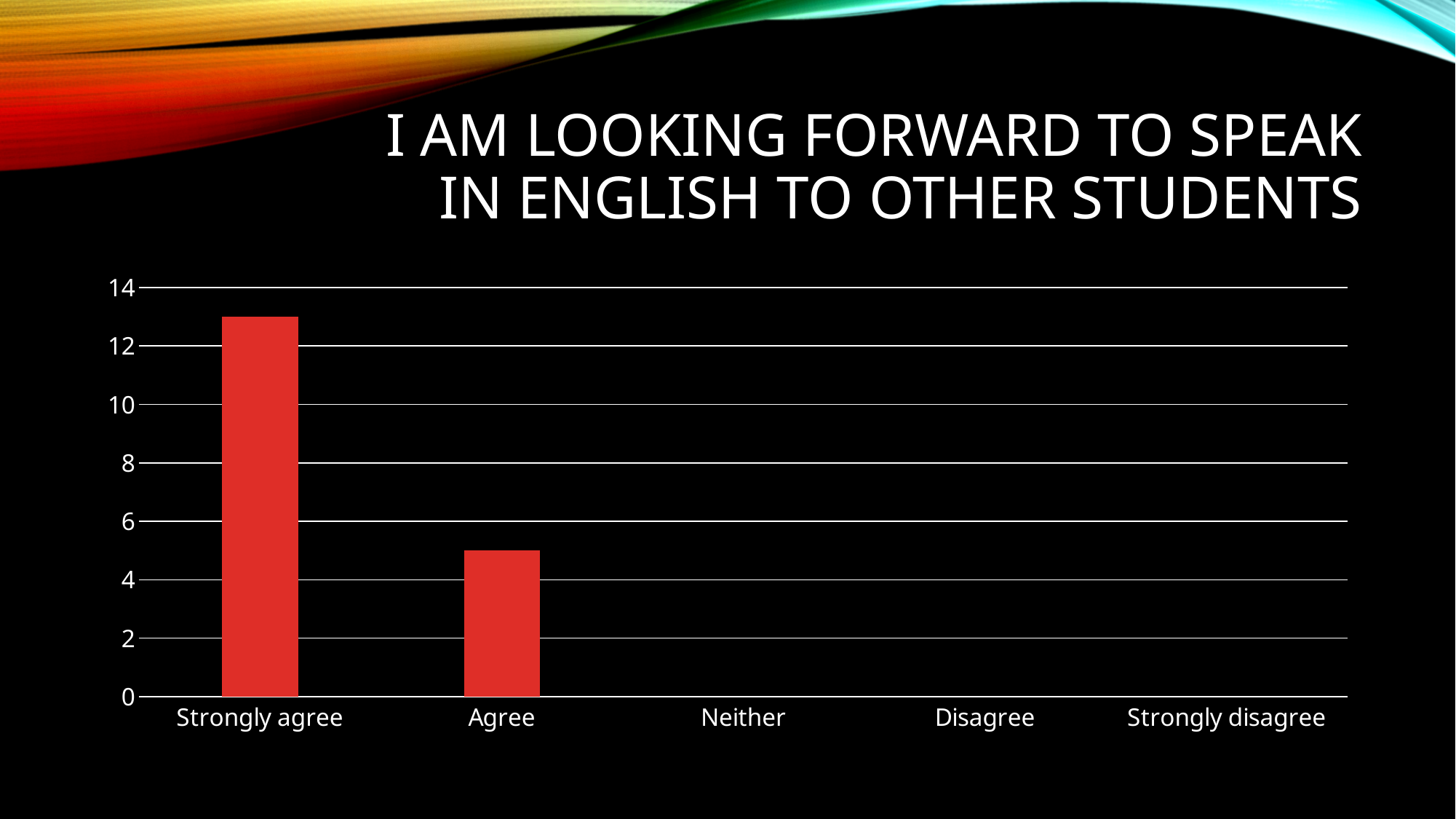
What kind of chart is shown on the slide? bar chart Is the value for Strongly agree greater or less than 12? greater Is the value for Strongly agree greater or less than 14? less Which category has the highest value in the chart? Strongly agree How many categories are shown on the x axis of the chart? 5 Do the values rise or fall moving from Strongly agree to Strongly disagree along the x axis? fall Which is larger, the value for Strongly agree or the value for Agree? Strongly agree What colour are the bars in the chart? red What is the title of the slide containing the chart? I am looking forward to speak in English to other students Is the value for Agree greater or less than 4? greater